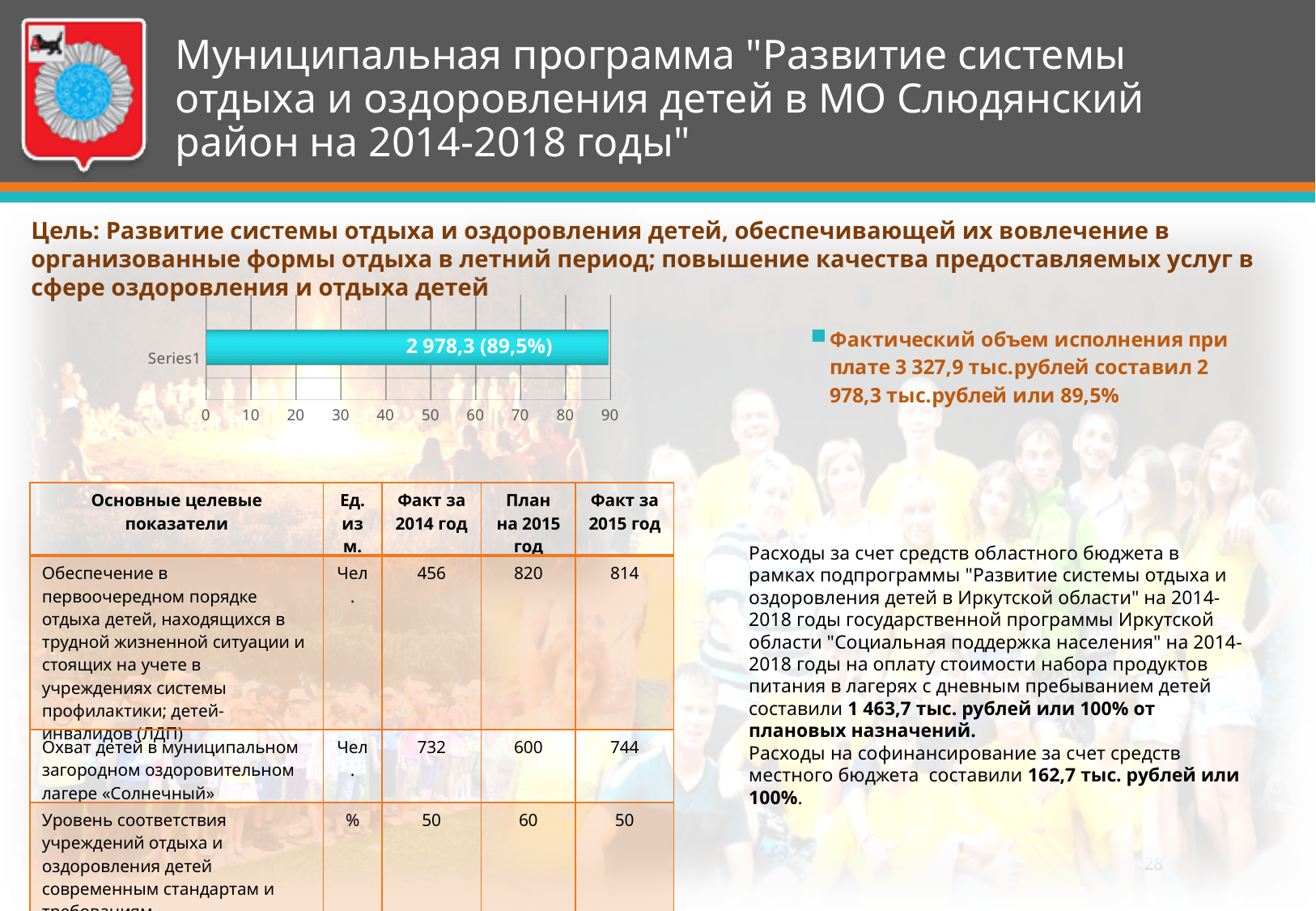
What is the highest tick value shown on the horizontal axis of the chart? 90 Is the value for Series1 greater or less than 50 on the horizontal axis? greater What kind of chart is shown on the slide? bar chart Is the value for Series1 greater or less than 80 on the horizontal axis? greater What is the category label shown on the vertical axis of the chart? Series1 How many bars are plotted in the chart? 1 What data label is printed on the bar in the chart? 2 978,3 (89,5%) What percentage is shown in parentheses in the bar's data label? 89,5%